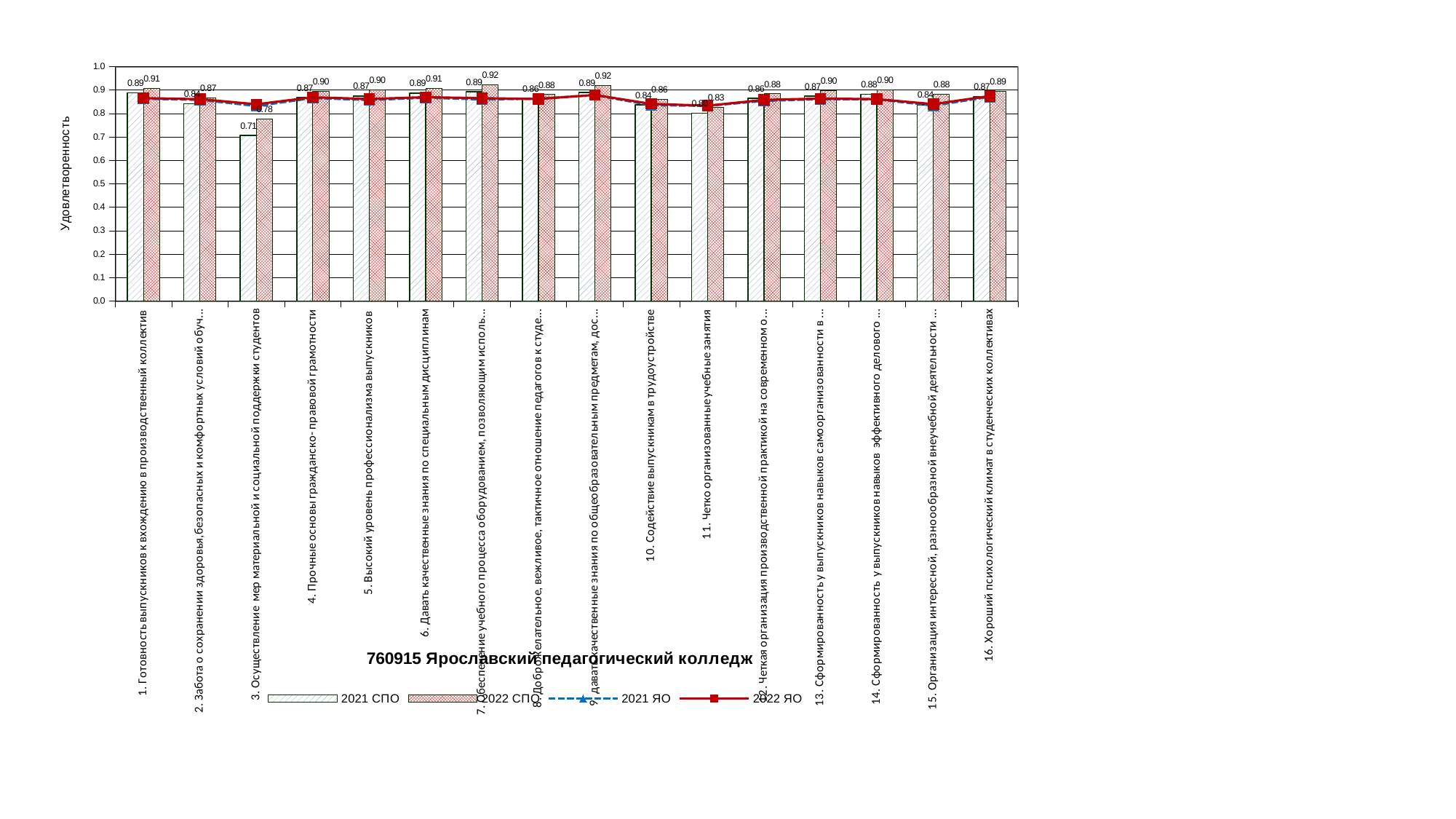
For category 1 (Готовность выпускников к вхождению в производственный коллектив), which is larger: the 2021 СПО value or the 2022 СПО value? 2022 СПО Is the 2021 СПО value for category 3 (Осуществление мер материальной и социальной поддержки студентов) greater or less than 0.8? less How many series does the legend list? 4 What is the 2022 СПО value for category 16 (Хороший психологический климат в студенческих коллективах)? 0.89 What is the 2021 СПО value for category 3 (Осуществление мер материальной и социальной поддержки студентов)? 0.71 How many categories are plotted along the x axis? 16 What is the difference between the 2022 СПО and 2021 СПО values for category 3 (Осуществление мер материальной и социальной поддержки студентов)? 0.07 What kind of chart is shown on the slide? A combined bar and line chart What is the title of the chart? 760915 Ярославский педагогический колледж What is the 2022 СПО value for category 3 (Осуществление мер материальной и социальной поддержки студентов)? 0.78 Which category has the lowest 2021 СПО bar? 3. Осуществление мер материальной и социальной поддержки студентов What is the 2021 СПО value for category 10 (Содействие выпускникам в трудоустройстве)? 0.84